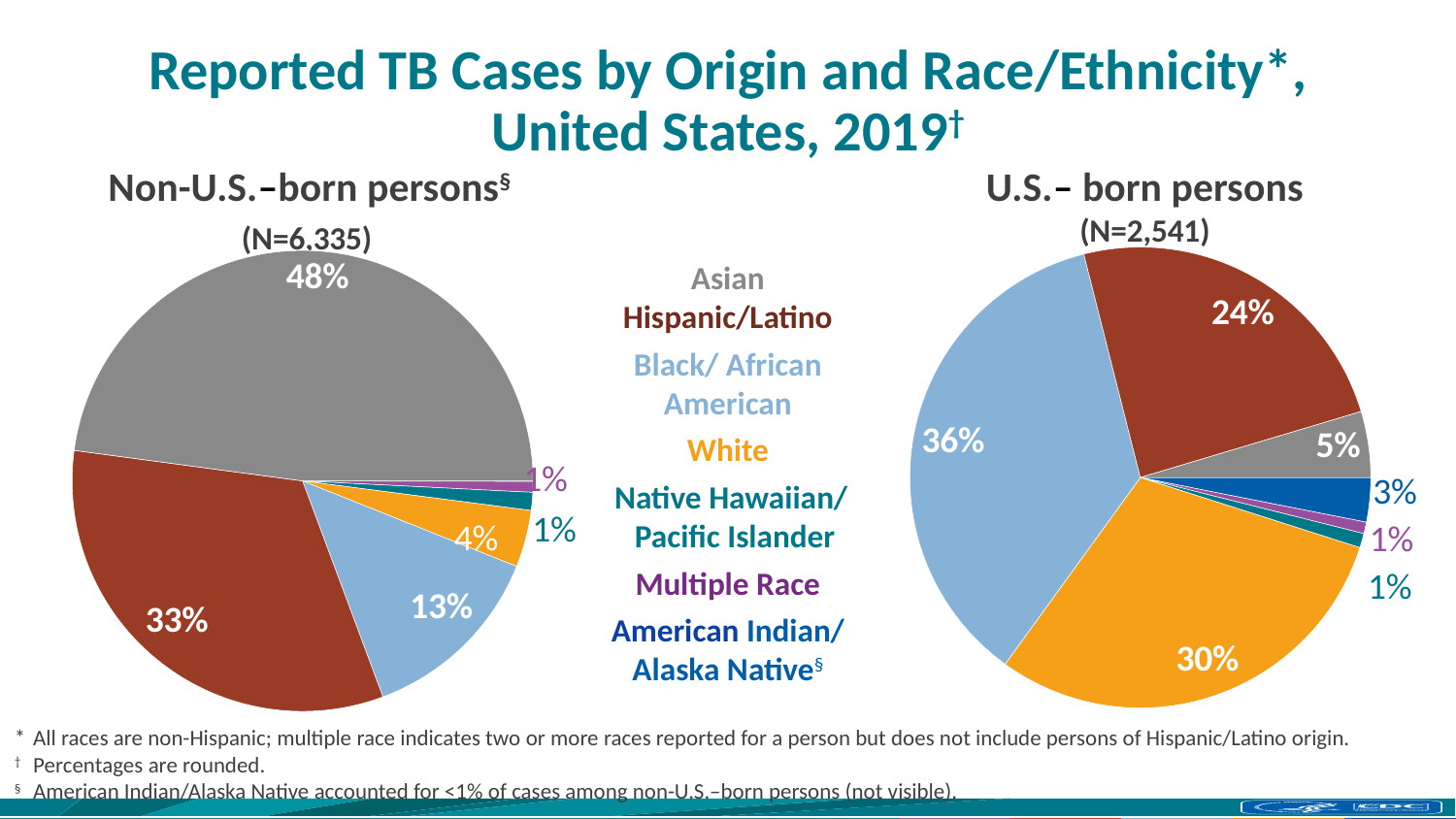
In the Non-U.S.-born persons chart, what percentage of cases is Asian? 48% How many race/ethnicity categories does the legend list? 7 What is the N value shown for the U.S.-born persons chart? N=2,541 What type of charts are shown on the slide? Pie charts In the U.S.-born persons chart, what percentage of cases is White? 30% In the Non-U.S.-born persons chart, what percentage of cases is Hispanic/Latino? 33% In the U.S.-born persons chart, what percentage of cases is Black/African American? 36% In the U.S.-born persons chart, which race/ethnicity has the largest share? Black/African American In the U.S.-born persons chart, what percentage of cases is American Indian/Alaska Native? 3% Which is larger: the Hispanic/Latino share among Non-U.S.-born persons or among U.S.-born persons? Non-U.S.-born persons In the Non-U.S.-born persons chart, which race/ethnicity has the largest share? Asian What is the difference between the Asian share in the Non-U.S.-born persons chart and the Asian share in the U.S.-born persons chart? 43 percentage points